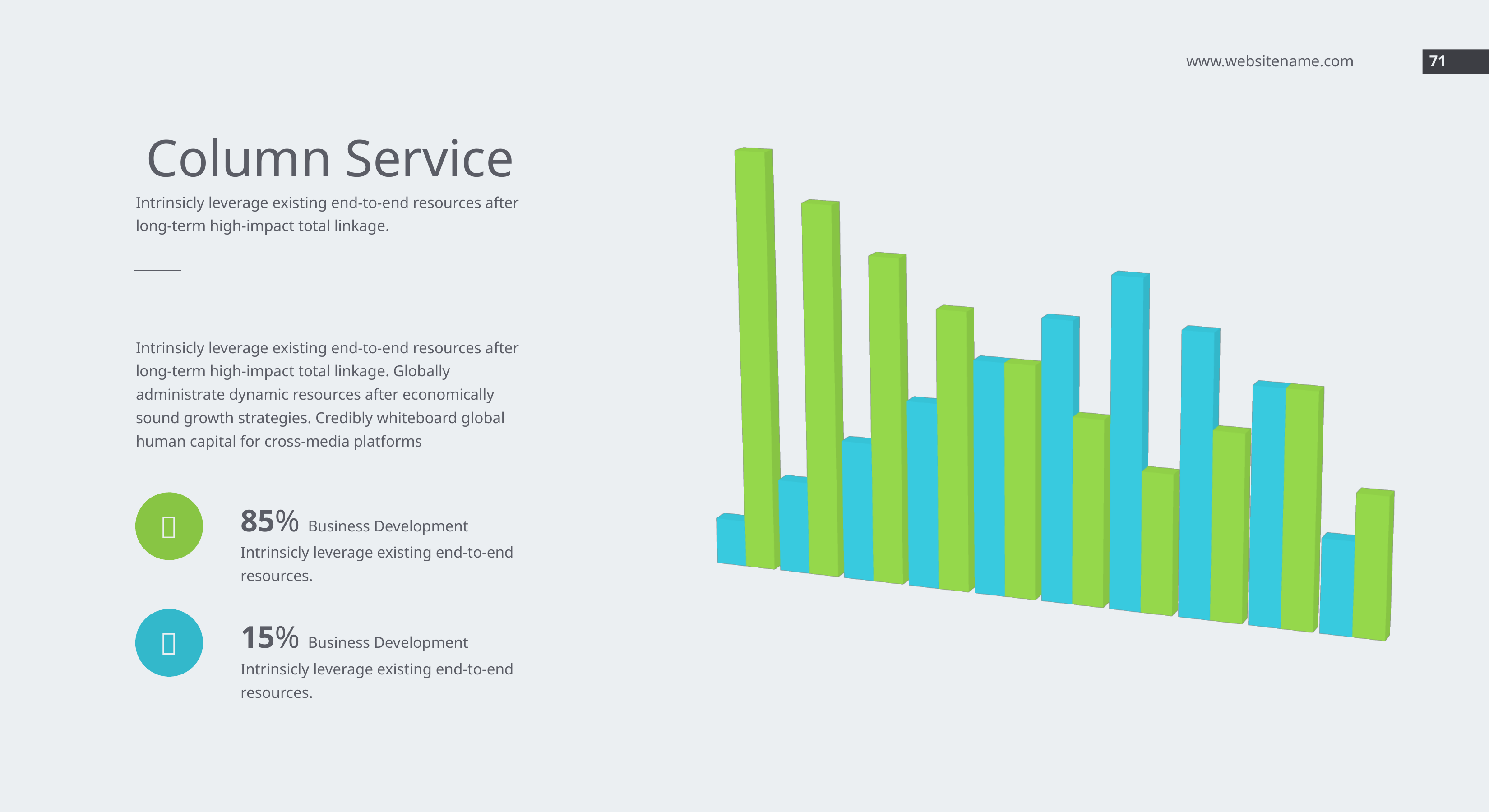
What colour is the shortest bar in the chart? blue Does the chart display a legend? No What kind of chart is shown on the slide? bar chart How many bars are plotted in the chart? 20 How many different bar colours does the chart use? 2 What colour is the tallest bar in the chart? green Is the tallest bar at the left end or the right end of the chart? left end How many green bars are in the chart? 10 Do the green bars generally rise or fall from left to right across the first five groups? fall How many blue bars are in the chart? 10